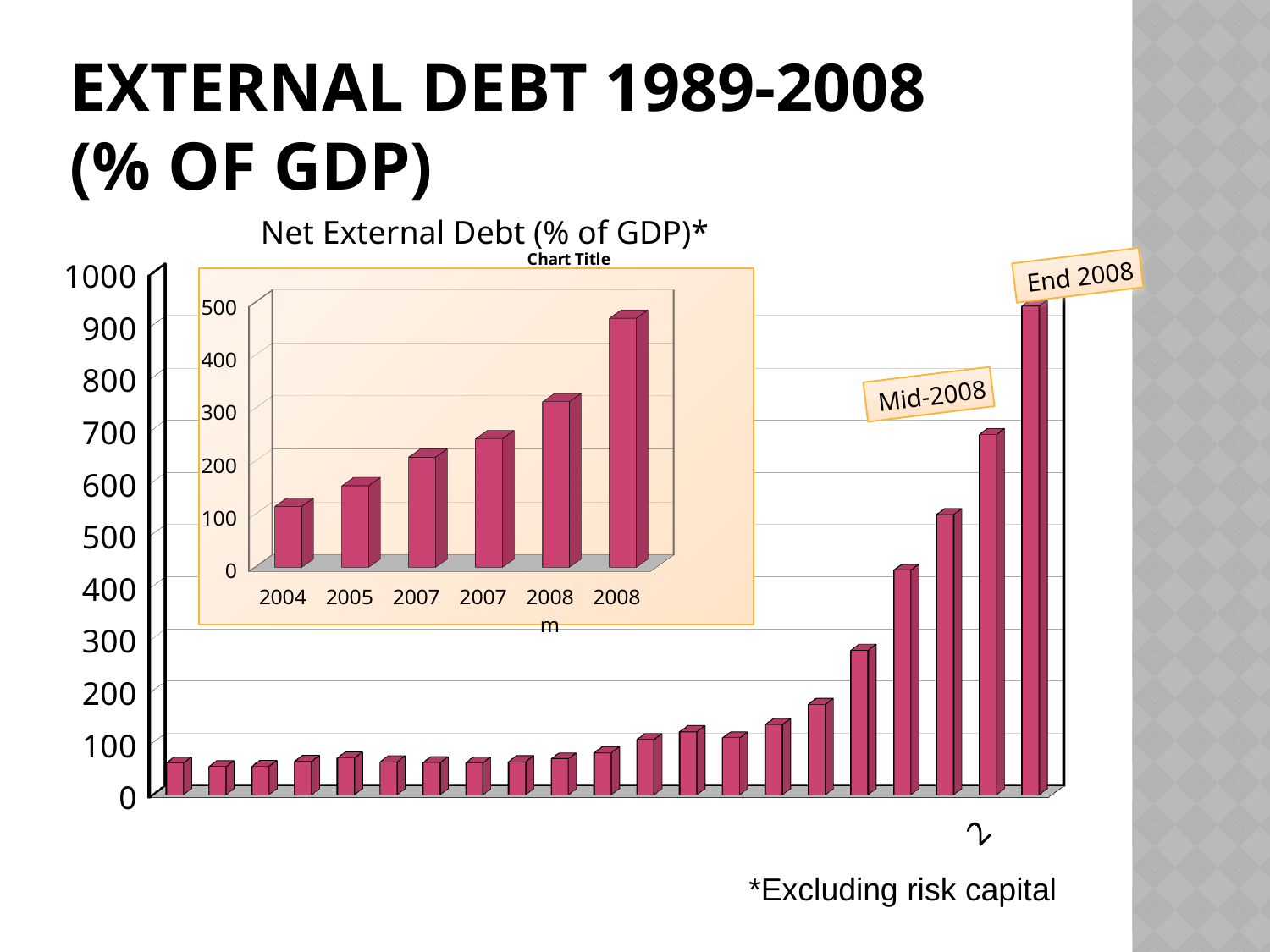
How many bars does the inset chart titled 'Chart Title' show? 6 What footnote text appears below the large chart on the slide? *Excluding risk capital In the large chart 'Net External Debt (% of GDP)*', which is larger, the Mid-2008 bar or the End 2008 bar? End 2008 In the inset chart titled 'Chart Title', is the value for the rightmost 2008 bar greater or less than 400? greater In the large chart 'Net External Debt (% of GDP)*', is the value for End 2008 greater or less than 900? greater What kind of chart is the large chart titled 'Net External Debt (% of GDP)*'? bar chart In the inset chart titled 'Chart Title', which category has the lowest bar? 2004 In the large chart 'Net External Debt (% of GDP)*', is the value for Mid-2008 greater or less than 600? greater In the large chart 'Net External Debt (% of GDP)*', do the values generally rise or fall from left to right? rise In the large chart 'Net External Debt (% of GDP)*', which labelled bar is the highest? End 2008 In the inset chart titled 'Chart Title', which is larger, the 2004 bar or the 2005 bar? 2005